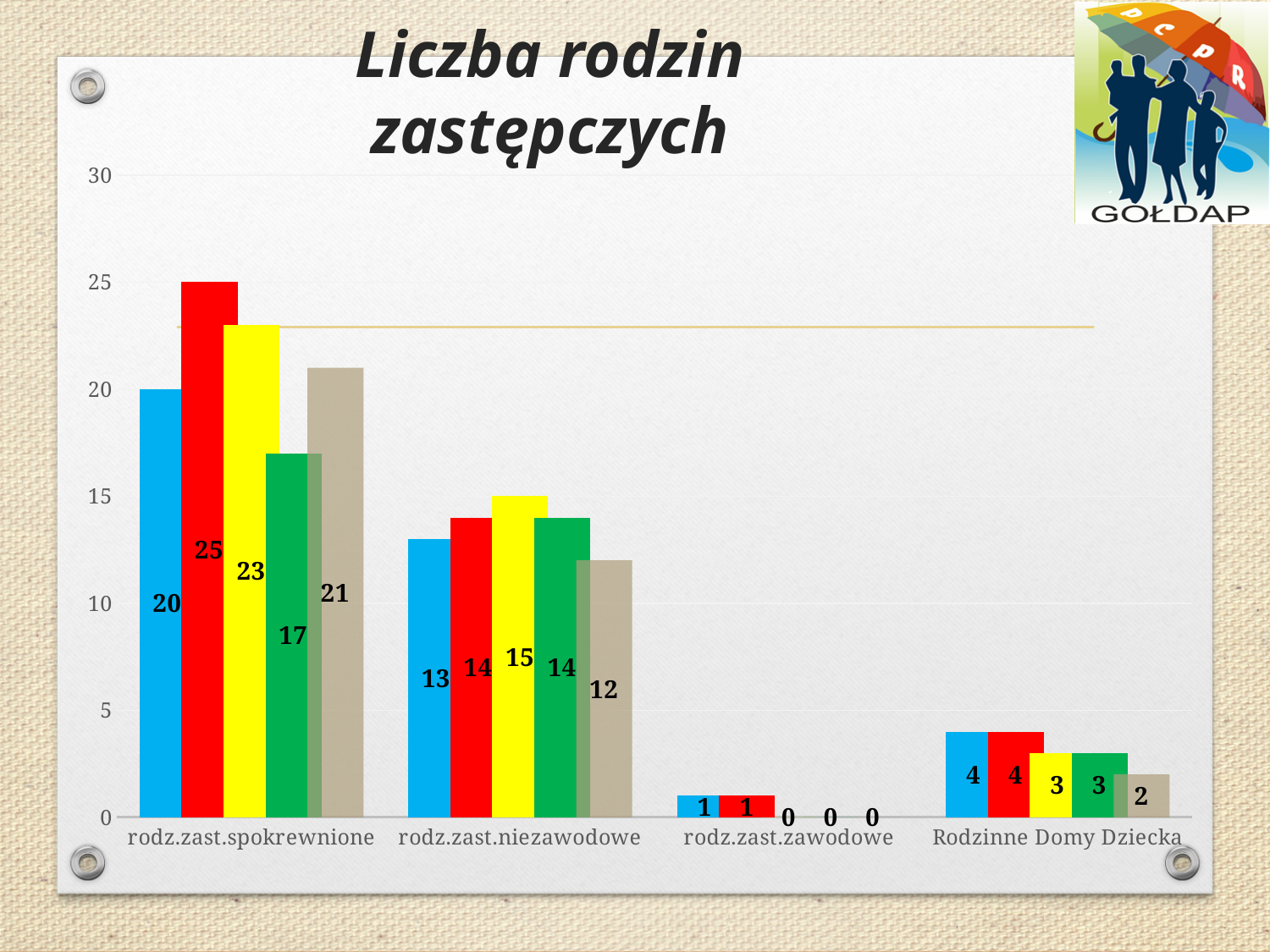
What kind of chart is shown on the slide? bar chart What is the value of the red bar for rodz.zast.spokrewnione? 25 How many categories are shown on the x axis? 4 Which is larger for rodz.zast.niezawodowe, the blue bar or the yellow bar? the yellow bar Which category has the highest bar overall? rodz.zast.spokrewnione What is the difference between the red bar and the green bar for rodz.zast.spokrewnione? 8 What is the value of the beige bar for Rodzinne Domy Dziecka? 2 How many bars are plotted for each category? 5 What is the value of the yellow bar for rodz.zast.niezawodowe? 15 Which category has the lowest values overall? rodz.zast.zawodowe What is the value of the blue bar for rodz.zast.zawodowe? 1 What is the title of the chart? Liczba rodzin zastępczych